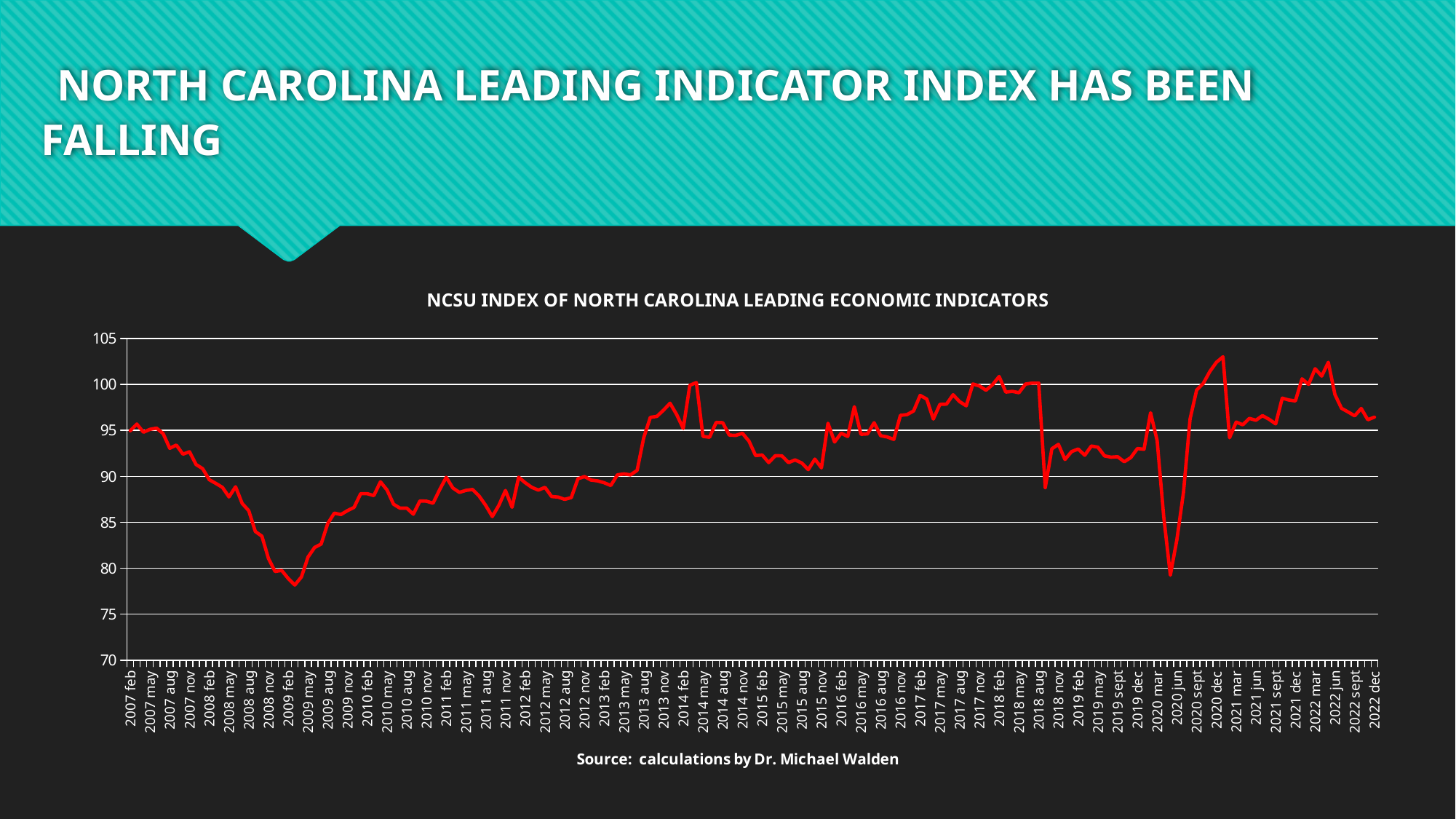
Is the value for 2012 aug greater or less than 90? less Which is larger, the value for 2009 feb or the value for 2020 dec? 2020 dec Does the index rise or fall between 2022 mar and 2022 dec? fall Is the value for 2020 dec greater or less than 100? greater What kind of chart is shown on the slide? line chart Is the value for 2008 aug greater or less than 85? greater What is the title of the chart? NCSU INDEX OF NORTH CAROLINA LEADING ECONOMIC INDICATORS Which is larger, the value for 2007 feb or the value for 2008 nov? 2007 feb What colour is the line plotted on the chart? red